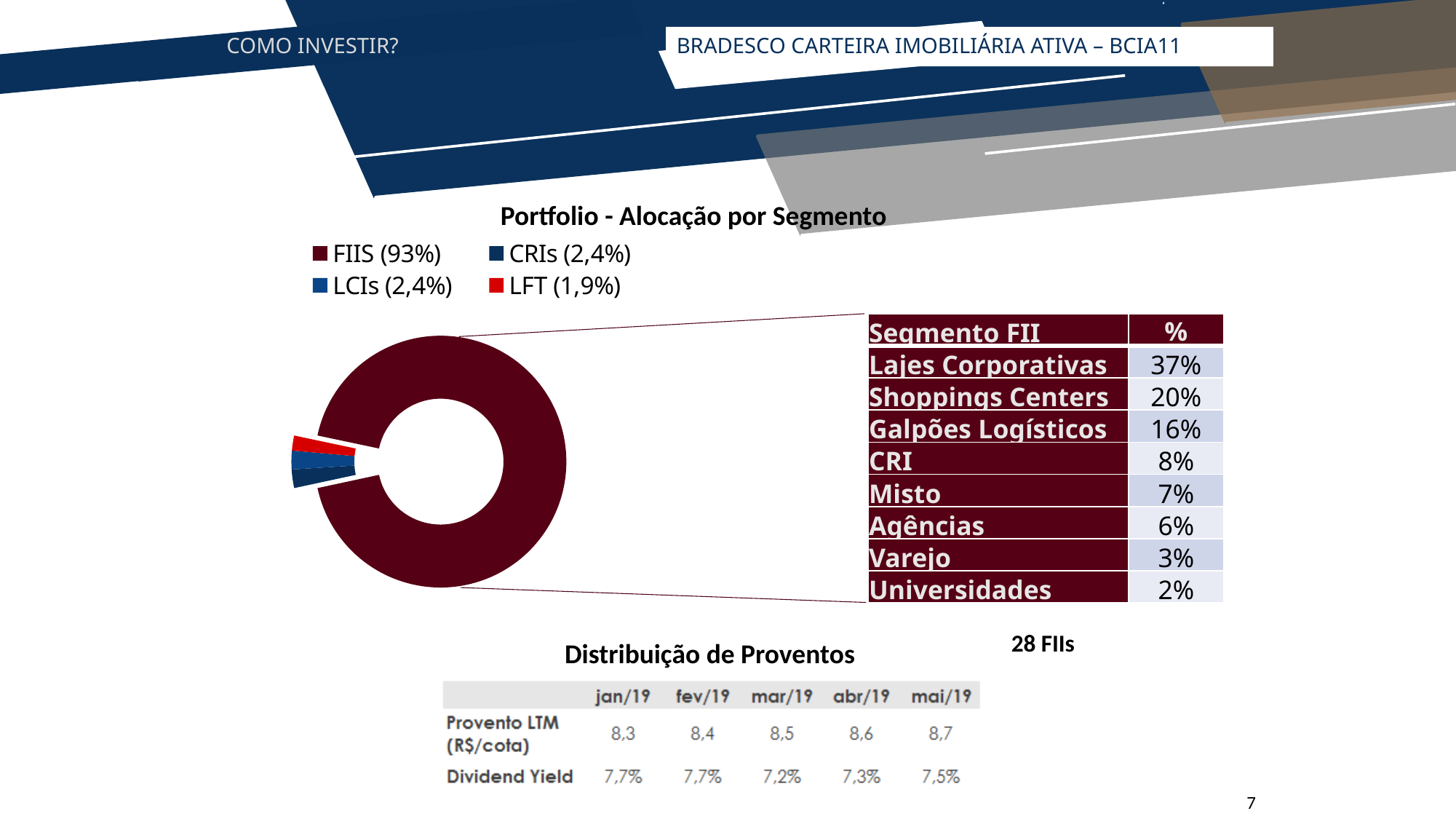
In the "Portfolio - Alocação por Segmento" chart, what share of the portfolio is allocated to FIIS? 93% What kind of chart is shown under the title "Portfolio - Alocação por Segmento"? Pie (doughnut) chart What colour is the LFT slice in the "Portfolio - Alocação por Segmento" chart? Red In the "Portfolio - Alocação por Segmento" chart, what share is allocated to LCIs? 2,4% In the "Portfolio - Alocação por Segmento" chart, what share is allocated to LFT? 1,9% How many categories does the legend of the "Portfolio - Alocação por Segmento" chart list? 4 Which category has the smallest slice in the "Portfolio - Alocação por Segmento" chart? LFT In the "Portfolio - Alocação por Segmento" chart, what is the difference between the LCIs share and the LFT share? 0,5% In the "Portfolio - Alocação por Segmento" chart, which is larger: the share for LCIs or the share for LFT? LCIs In the "Portfolio - Alocação por Segmento" chart, what share is allocated to CRIs? 2,4% Which category has the largest slice in the "Portfolio - Alocação por Segmento" chart? FIIS In the "Portfolio - Alocação por Segmento" chart, what is the difference between the FIIS share and the LFT share? 91,1%